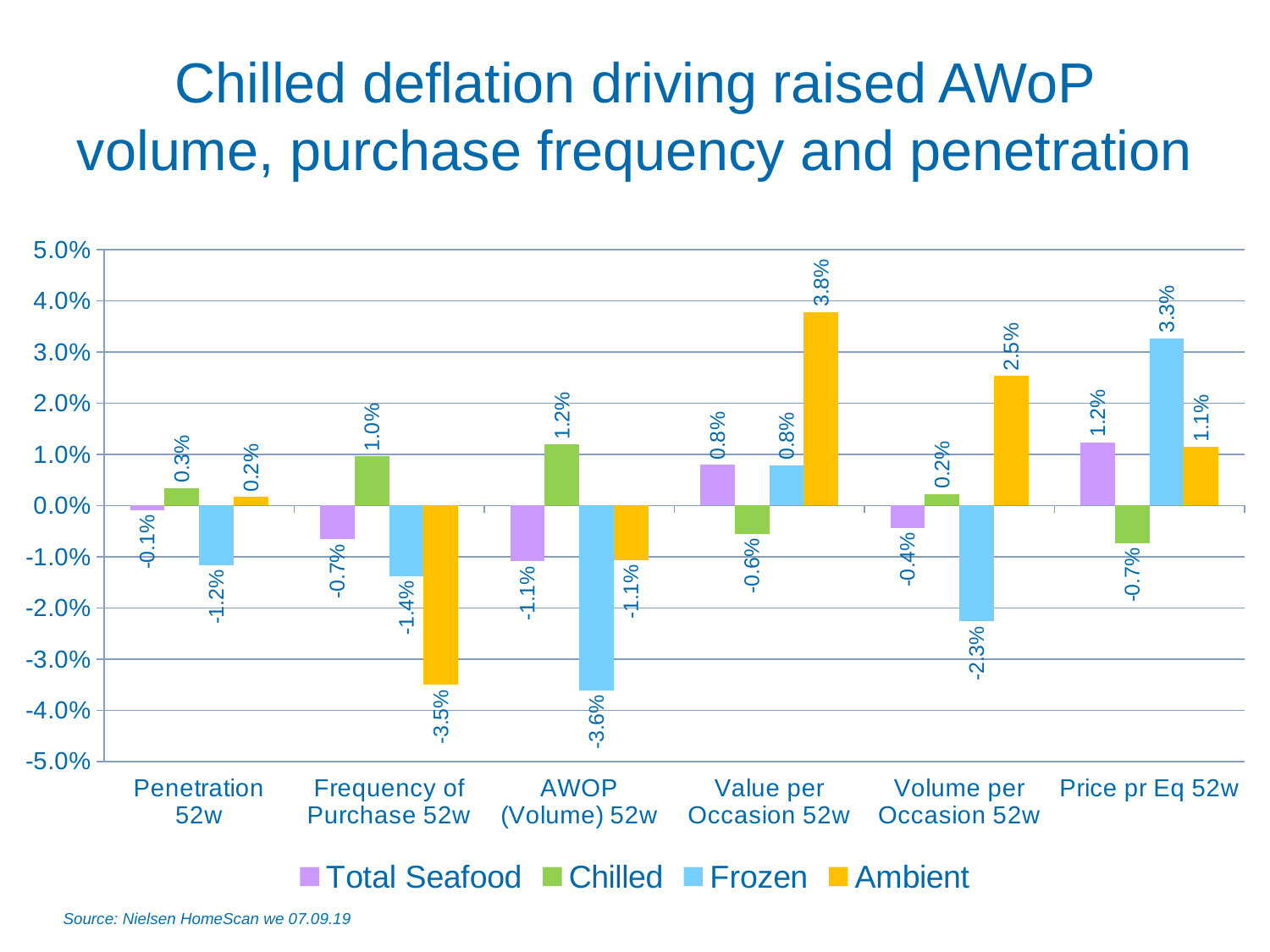
How many categories are shown on the x axis? 6 Which is larger in the Penetration 52w category: the Chilled value or the Ambient value? Chilled Which series has the highest value in the Price pr Eq 52w category? Frozen What kind of chart is shown on the slide? Bar chart What is the value for Frozen in the AWOP (Volume) 52w category? -3.6% What is the value for Ambient in the Value per Occasion 52w category? 3.8% What is the value for Total Seafood in the Price pr Eq 52w category? 1.2% How many series does the legend list? 4 What is the value for Chilled in the Frequency of Purchase 52w category? 1.0% What is the difference between the Ambient and Frozen values in the Volume per Occasion 52w category? 4.8% Which series has the lowest value in the Frequency of Purchase 52w category? Ambient What colour represents the Ambient series? Yellow